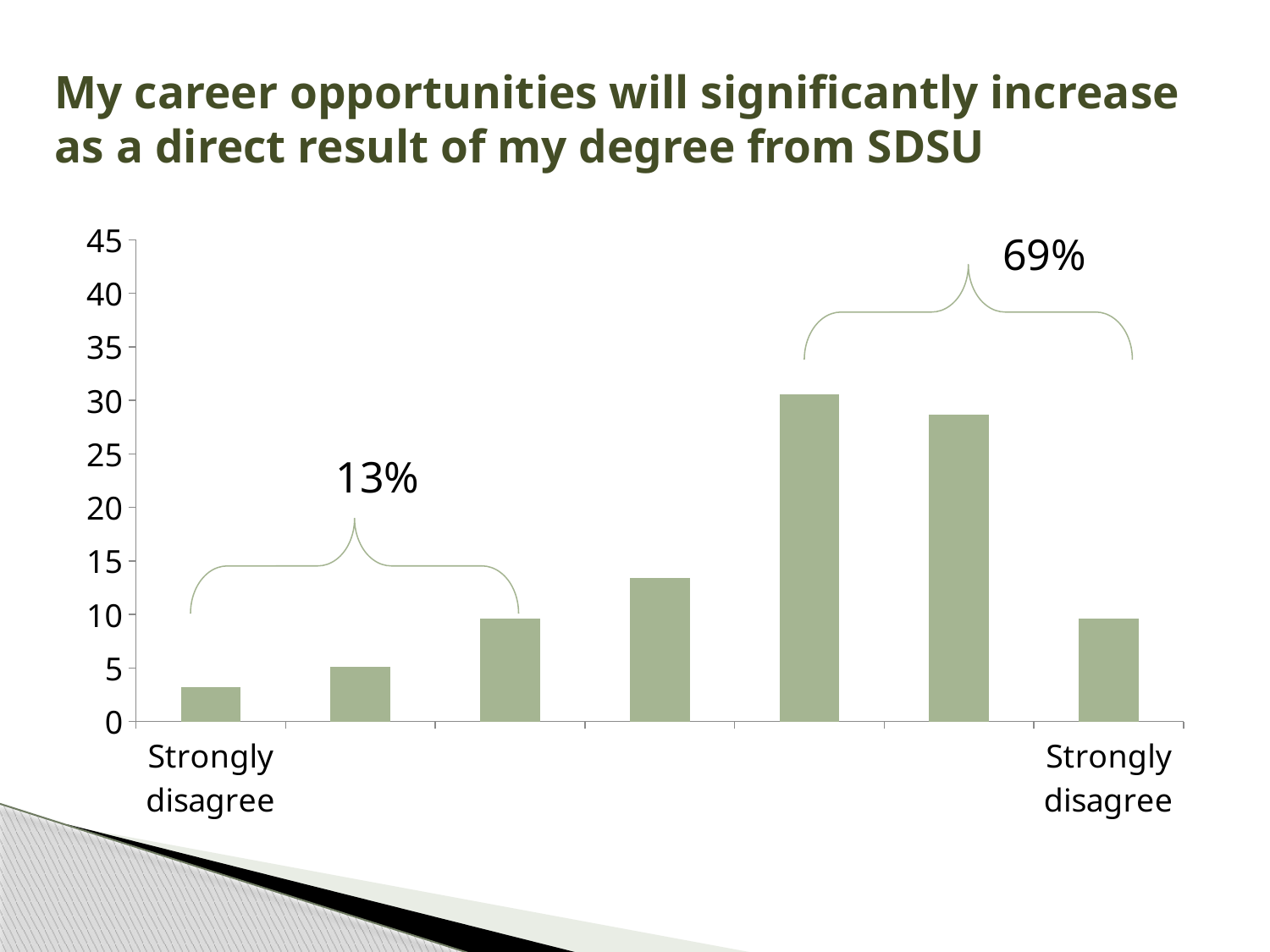
What percentage is shown above the bracket covering the last three bars? 69% Is the value of the second bar from the left greater or less than 10? less Is the value of the leftmost bar (Strongly disagree) greater or less than 5? less Which bar is the lowest in the chart? the leftmost bar (Strongly disagree) Which is larger, the fourth bar from the left or the fifth bar from the left? the fifth bar What kind of chart is shown on the slide? bar chart Which is larger, the leftmost bar or the rightmost bar? the rightmost bar How many bars does the chart contain? 7 Is the value of the fifth bar from the left greater or less than 25? greater What is the title of the chart on the slide? My career opportunities will significantly increase as a direct result of my degree from SDSU What percentage is shown above the bracket covering the first three bars? 13%